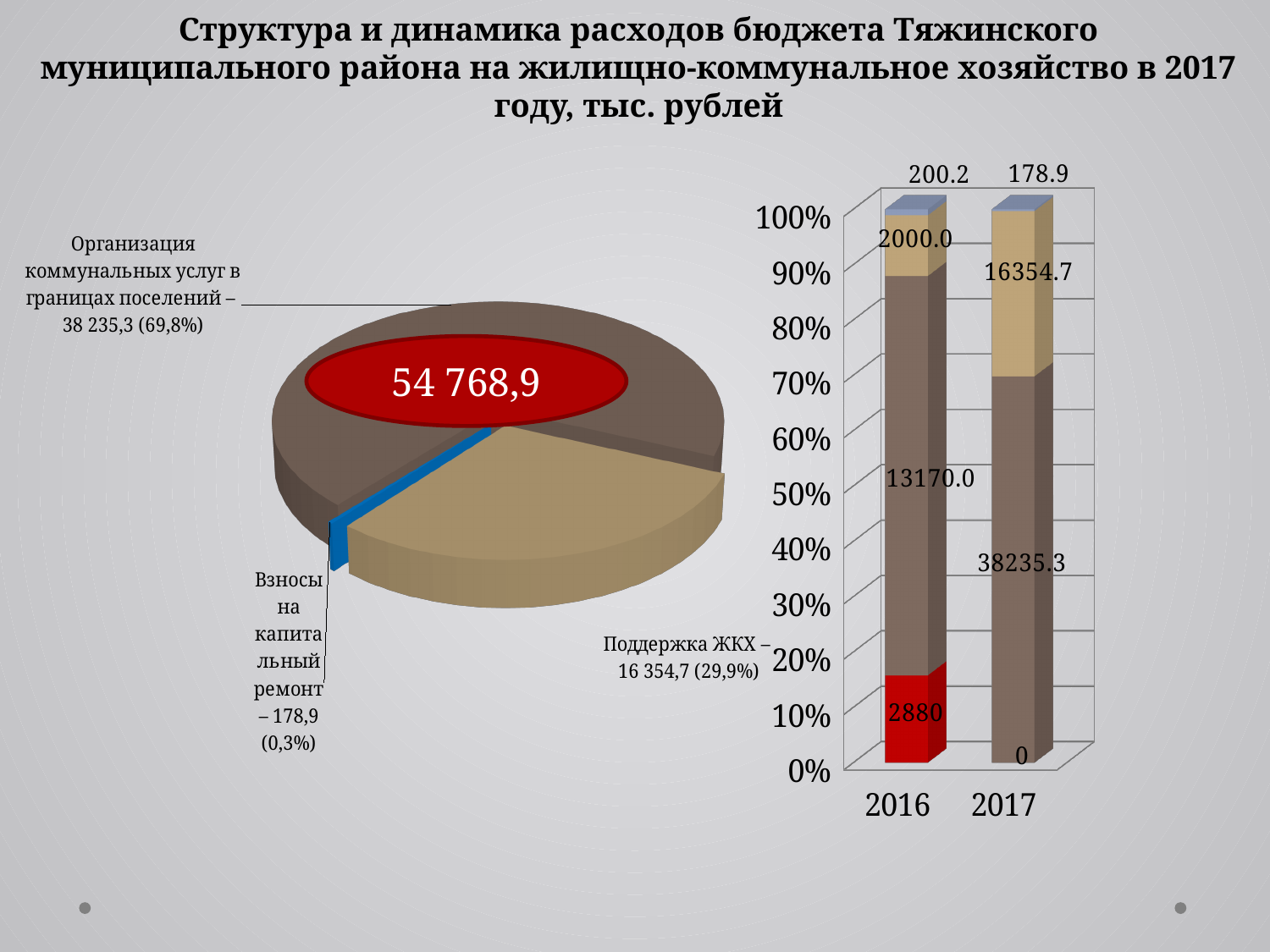
In the pie chart on the left, what is the value for "Организация коммунальных услуг в границах поселений"? 38 235,3 In the bar chart on the right, what is the value of the topmost segment for 2017? 178.9 In the bar chart on the right, what is the difference between the brown segment values for 2017 (38235.3) and 2016 (13170.0)? 25065.3 How many years (categories) are shown on the x axis of the bar chart on the right? 2 What total value is printed in the centre of the pie chart on the left? 54 768,9 In the bar chart on the right, what is the value of the red bottom segment for 2016? 2880 In the pie chart on the left, which category has the smallest slice? Взносы на капитальный ремонт How many slices does the pie chart on the left have? 3 In the pie chart on the left, what share of the total does "Поддержка ЖКХ" account for? 29,9% What kind of chart is shown on the right of the slide? bar chart In the bar chart on the right, which year has the larger value for the brown segment: 2016 (13170.0) or 2017 (38235.3)? 2017 In the pie chart on the left, which category has the largest slice? Организация коммунальных услуг в границах поселений